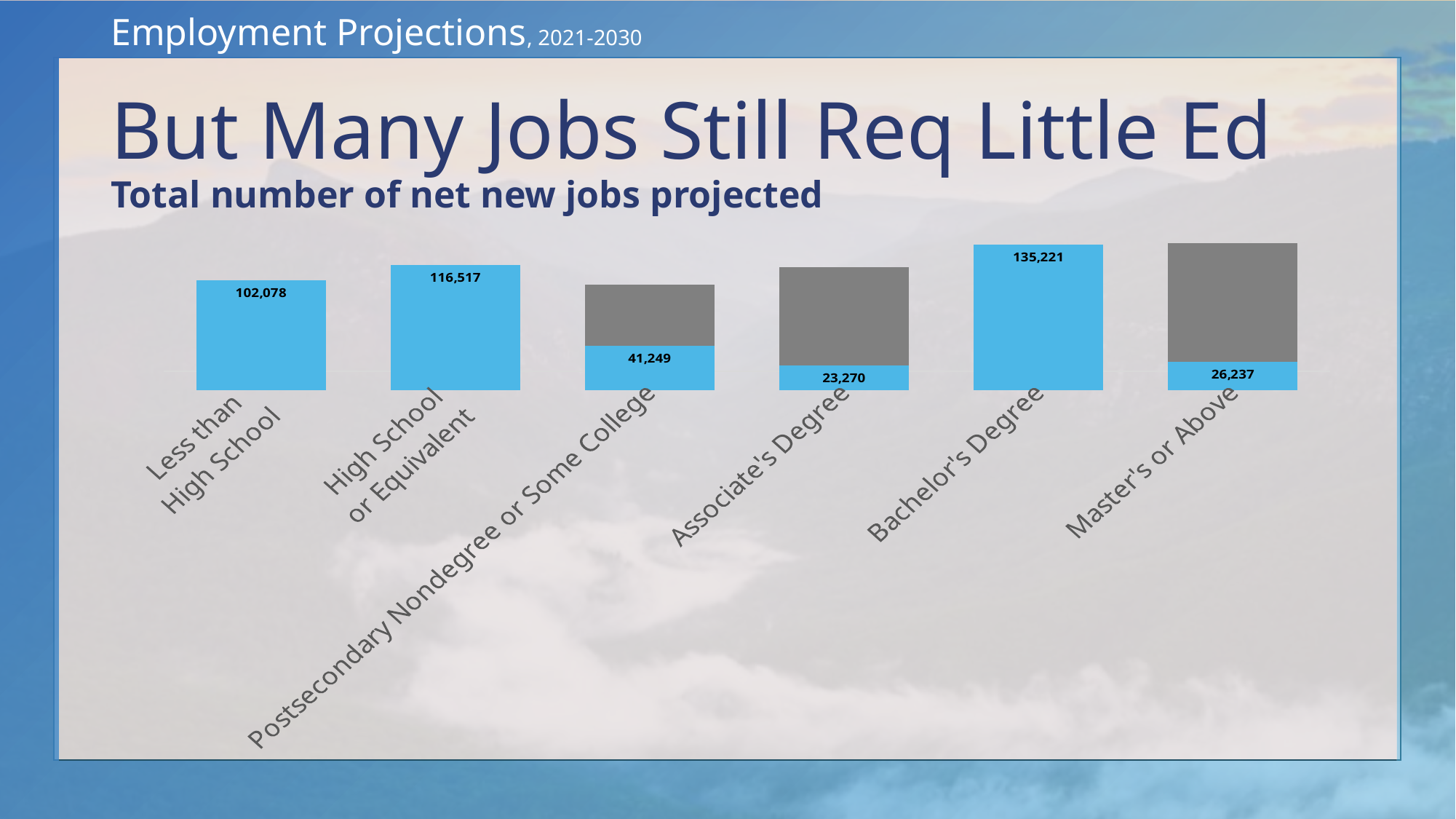
Which education category has the highest number of net new jobs projected? Bachelor's Degree Which has more net new jobs projected: Postsecondary Nondegree or Some College, or Master's or Above? Postsecondary Nondegree or Some College What is the difference between the net new jobs projected for Bachelor's Degree and High School or Equivalent? 18,704 How many education categories are shown in the chart? 6 What is the subtitle describing what the chart measures? Total number of net new jobs projected What kind of chart is shown on the slide? Bar chart What is the number of net new jobs projected for Postsecondary Nondegree or Some College? 41,249 Which education category has the lowest number of net new jobs projected? Associate's Degree What is the difference between the net new jobs projected for High School or Equivalent and Less than High School? 14,439 What is the number of net new jobs projected for Less than High School? 102,078 What is the number of net new jobs projected for Master's or Above? 26,237 What is the number of net new jobs projected for High School or Equivalent? 116,517